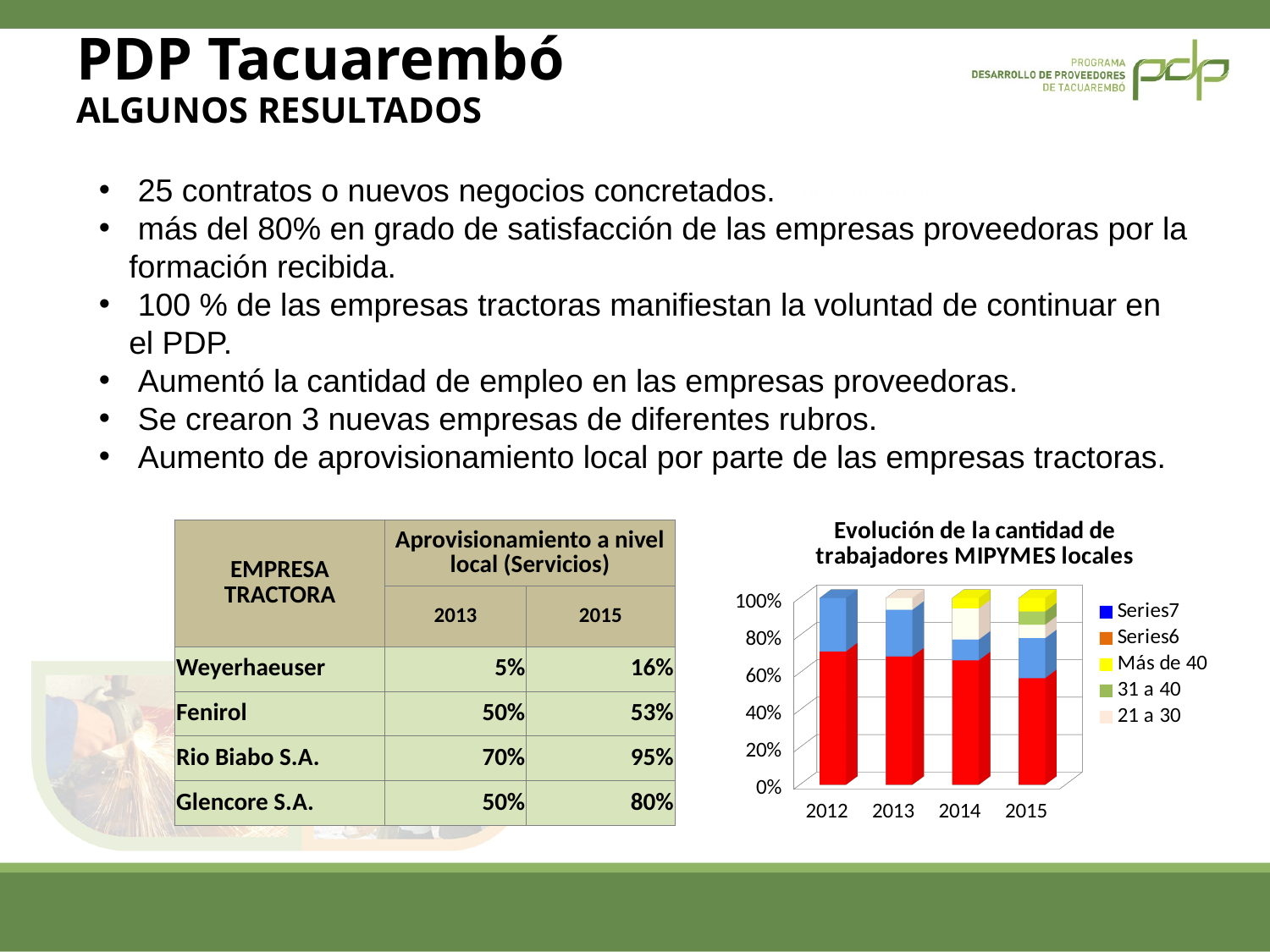
How many years are shown on the x axis of the chart? 4 Is the top of the red segment for 2012 greater or less than 60%? greater Is the red segment larger in 2012 or in 2015? 2012 What is the title of the chart on the slide? Evolución de la cantidad de trabajadores MIPYMES locales Does the red (bottom) segment of the bars rise or fall from 2012 to 2015? fall What is the highest value shown on the chart's y axis? 100% Which is the first year shown on the chart's x axis? 2012 How many entries does the chart's legend list? 5 Which year has the smallest red segment in the chart? 2015 Which year has the largest red segment in the chart? 2012 What kind of chart is shown on the slide? bar chart Is the top of the red segment for 2015 greater or less than 70%? less